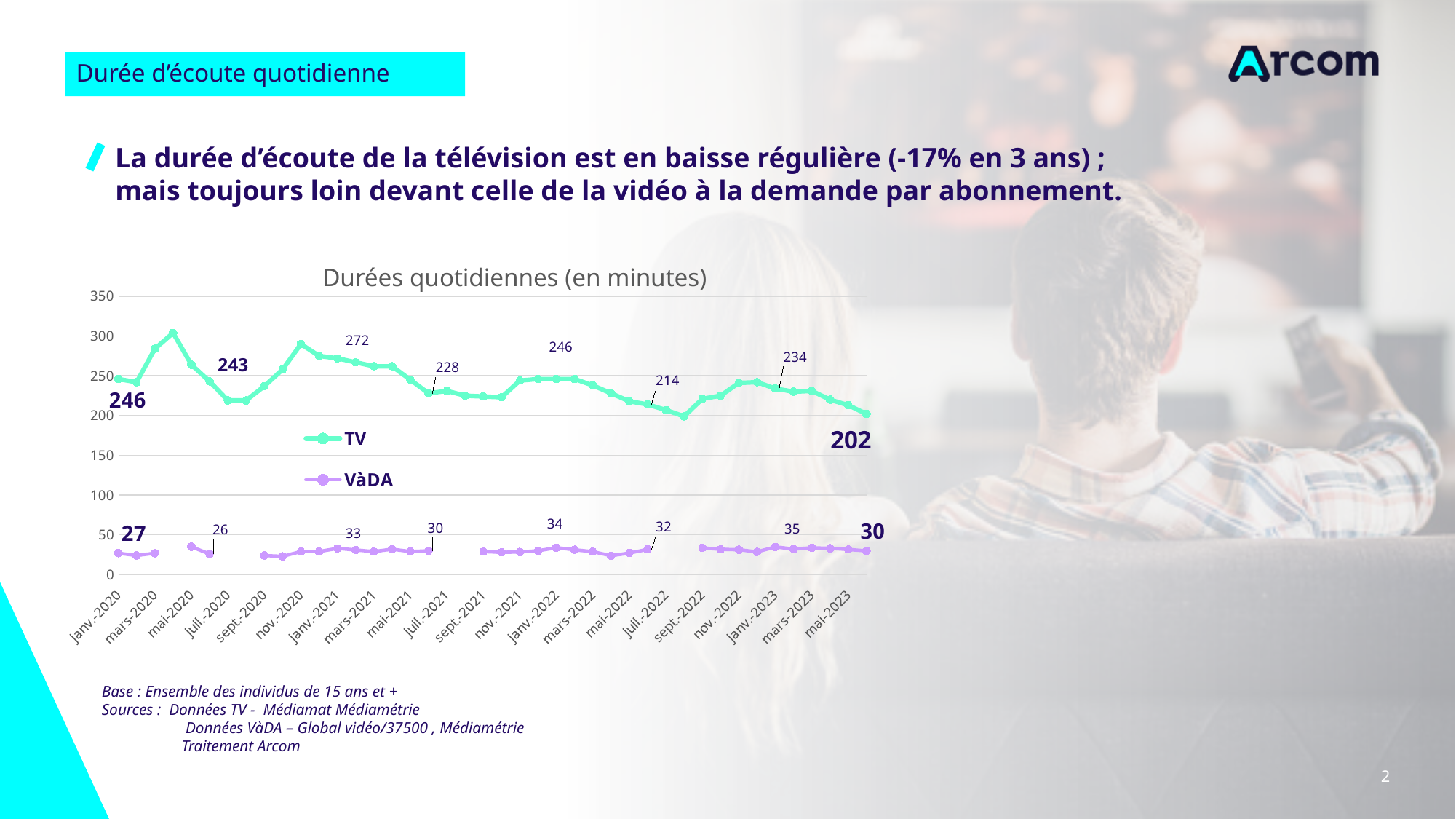
Is the VàDA value for janv.-2022 greater or less than 50? less What is the TV value for janv.-2022? 246 What kind of chart is shown on the slide? line chart What is the VàDA value for janv.-2023? 35 Does the TV series overall rise or fall from janv.-2020 to mai-2023? fall What is the VàDA value for janv.-2020? 27 What is the TV value for janv.-2020? 246 How many series does the chart legend list? 2 Which series has the larger value in mai-2023, TV or VàDA? TV